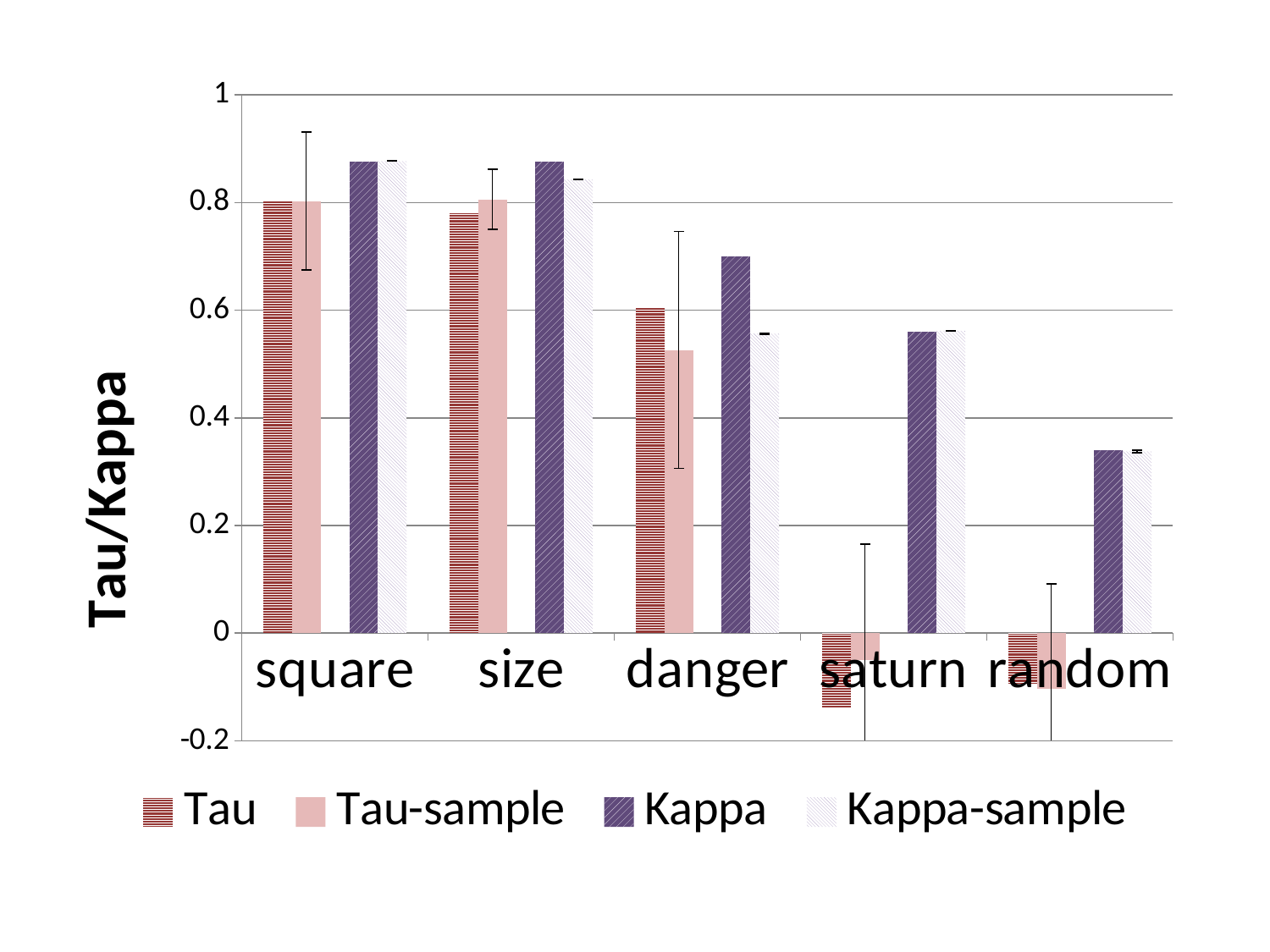
What is the title of the y axis? Tau/Kappa Is the Tau value for saturn greater or less than 0? less Is the Tau value for danger greater or less than 0.8? less Which category has the lowest Kappa value? random How many series does the legend list? 4 Do the Kappa values generally rise or fall moving from square to random along the x axis? fall Which is larger, the Kappa value for danger or the Kappa value for saturn? danger What kind of chart is shown on the slide? bar chart Which is larger, the Tau value for square or the Tau value for danger? square How many categories are shown along the x axis? 5 Is the Kappa value for danger greater or less than 0.6? greater